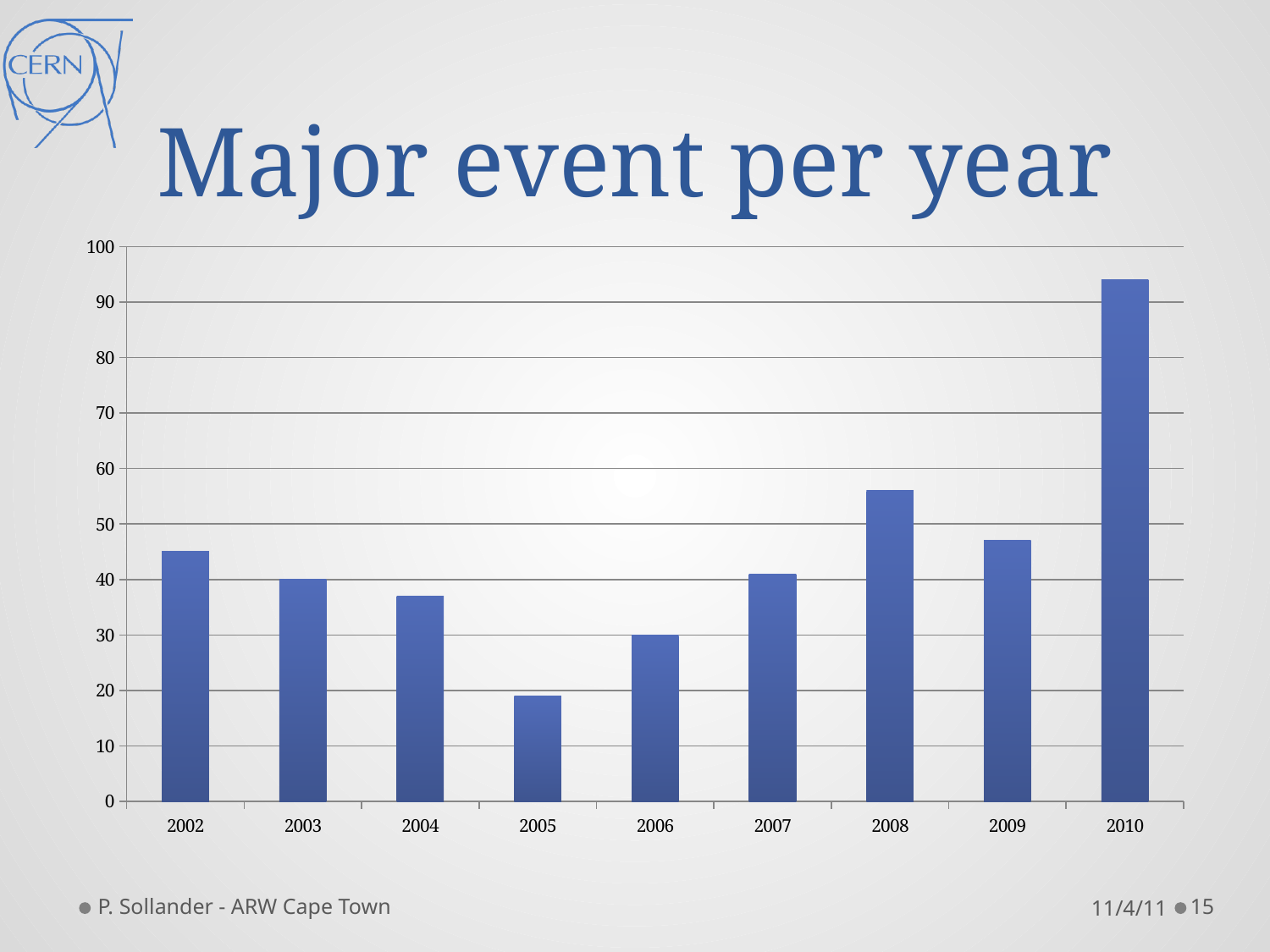
Is the value for 2008 greater or less than 50? greater How many years are shown on the x axis of the chart? 9 Which year has the lowest number of major events? 2005 What is the title of the chart? Major event per year Which year has the larger value, 2008 or 2009? 2008 Do the values rise or fall from 2002 to 2005? fall Which year has the highest number of major events? 2010 What is the value for 2003? 40 Is the value for 2010 greater or less than 90? greater What kind of chart is shown on the slide? bar chart What is the value for 2006? 30